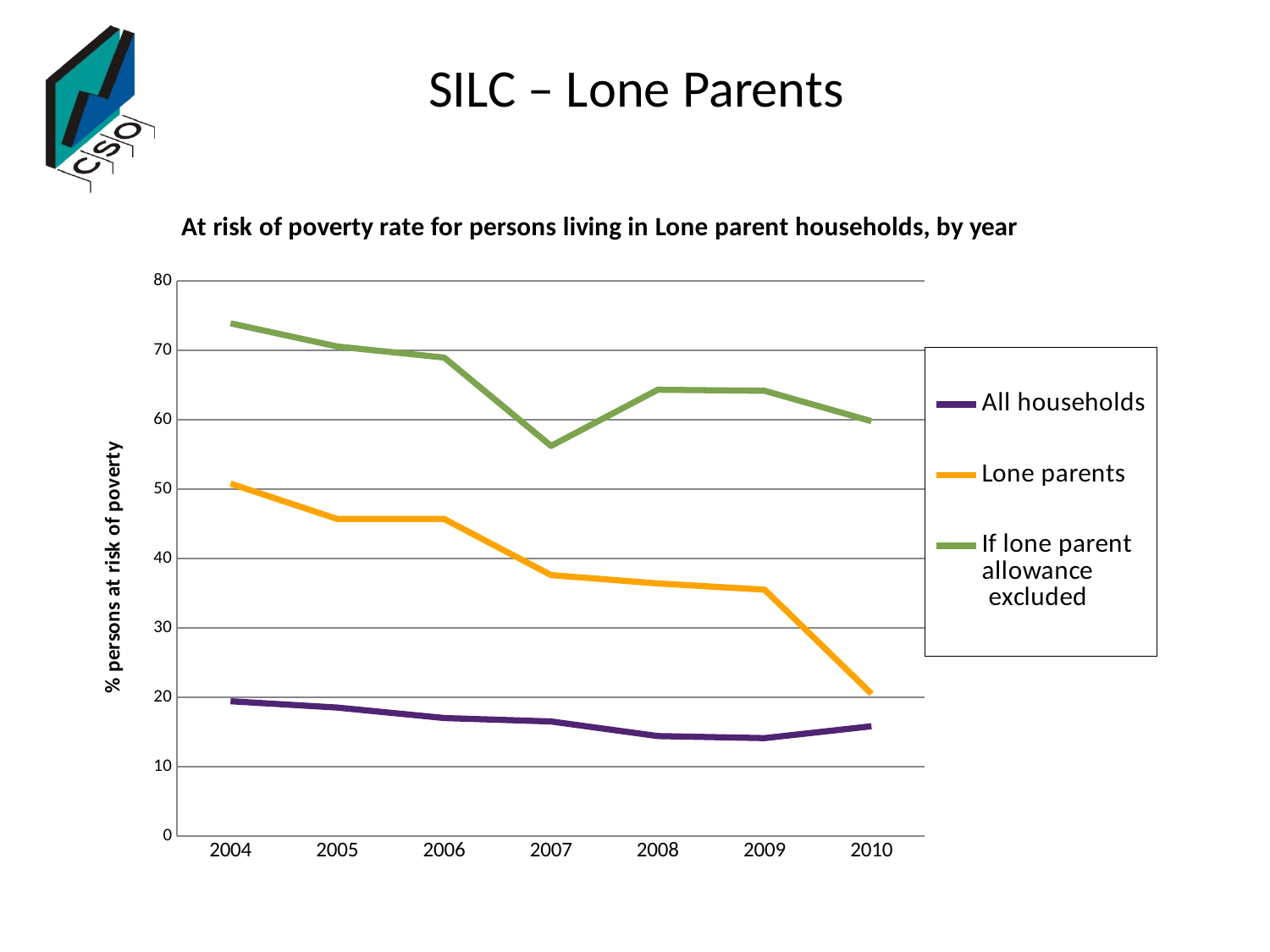
Is the value for All households in 2008 greater or less than 20? less How many years are plotted along the x axis? 7 Is the value for Lone parents in 2007 greater or less than 40? less Is the value for 'If lone parent allowance excluded' in 2004 greater or less than 70? greater What kind of chart is shown on the slide? line chart In which year is the 'If lone parent allowance excluded' series at its lowest? 2007 Does the Lone parents series generally rise or fall from 2004 to 2010? fall How many series does the legend list? 3 In which year is the Lone parents series at its highest? 2004 What is the title of the chart? At risk of poverty rate for persons living in Lone parent households, by year What is the label on the vertical axis? % persons at risk of poverty In 2010, which is larger: the Lone parents value or the All households value? Lone parents